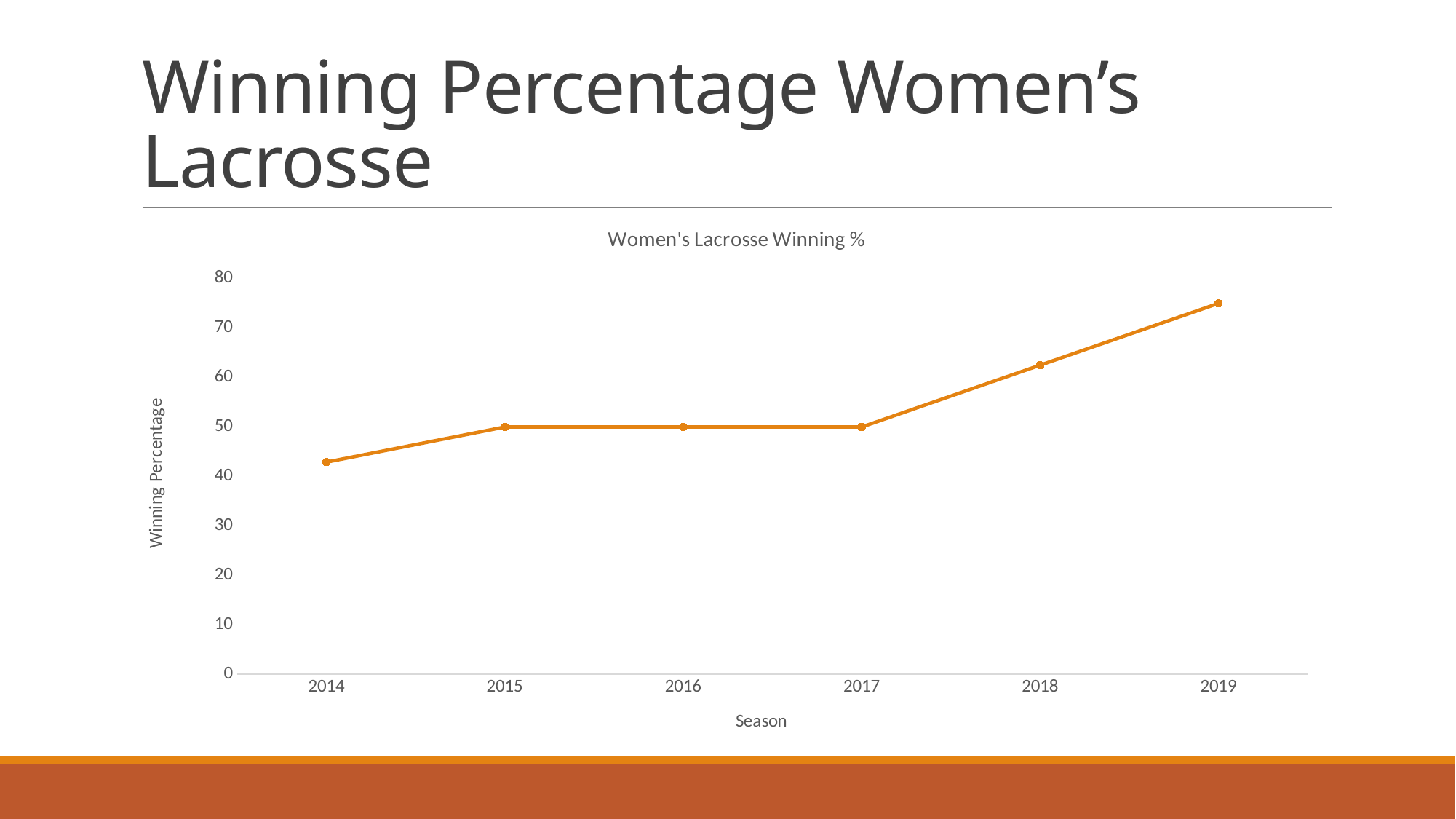
Which season has the highest winning percentage? 2019 Does the winning percentage generally rise or fall from 2014 to 2019? rise Is the winning percentage for 2014 greater or less than 50? less What kind of chart is shown on the slide? line chart Is the winning percentage for 2019 greater or less than 70? greater Is the winning percentage for 2018 greater or less than 70? less Which season has the lowest winning percentage? 2014 How many seasons are plotted on the x axis? 6 What is the label on the x axis of the chart? Season Which season has the higher winning percentage, 2018 or 2015? 2018 What is the title of the chart? Women's Lacrosse Winning %